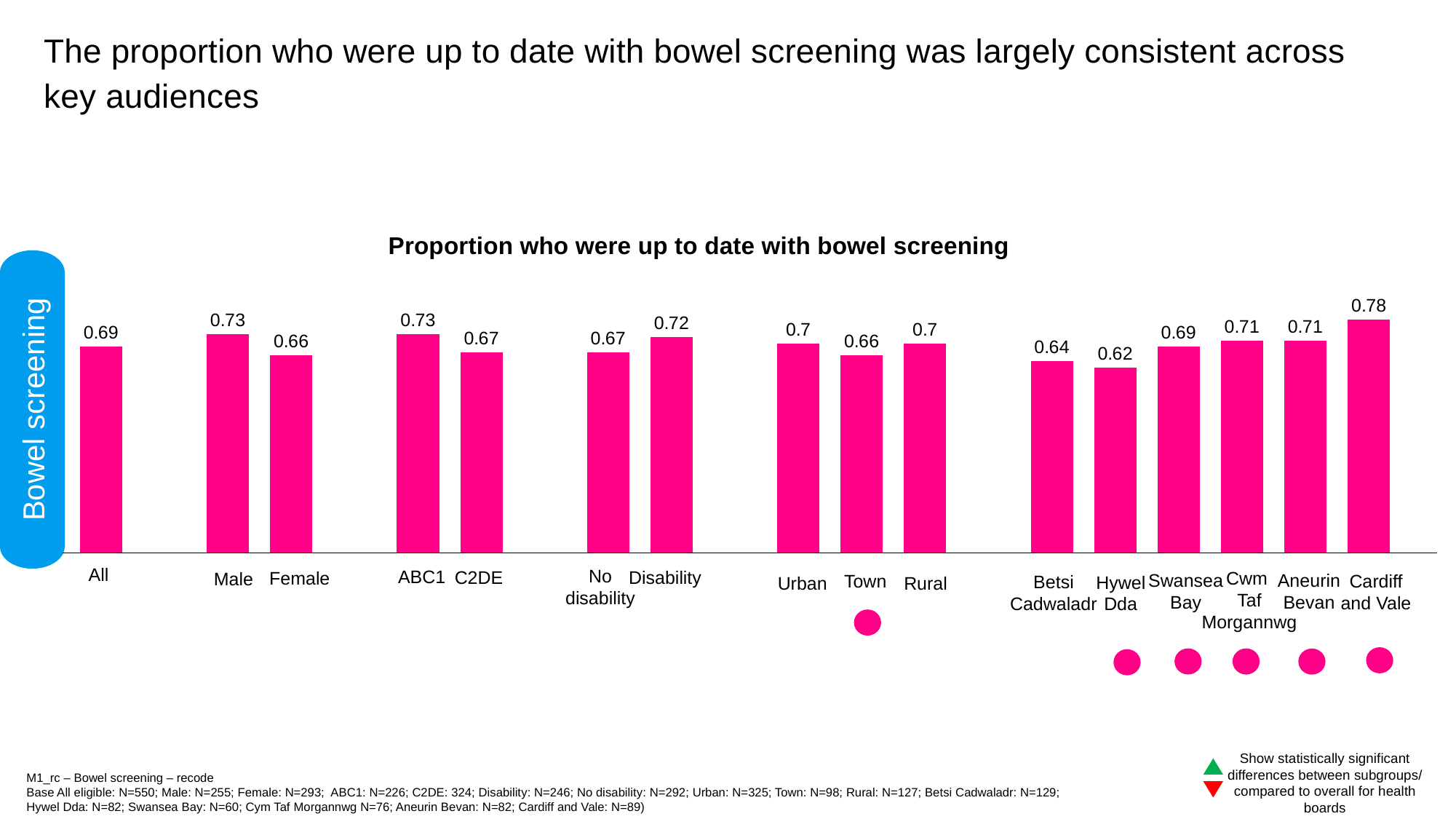
Which category has the highest value? Cardiff and Vale Which category has the lowest value? Hywel Dda What is the value for Disability? 0.72 What is the difference between the values for Male and Female? 0.07 What is the value for Cardiff and Vale? 0.78 How many categories are shown in the chart? 16 What is the difference between the values for Cardiff and Vale and Betsi Cadwaladr? 0.14 Which is larger, the value for Town or the value for Rural? Rural What kind of chart is shown on the slide? Bar chart What is the value for Hywel Dda? 0.62 What is the value for All in the chart? 0.69 Which is larger, the value for ABC1 or the value for C2DE? ABC1